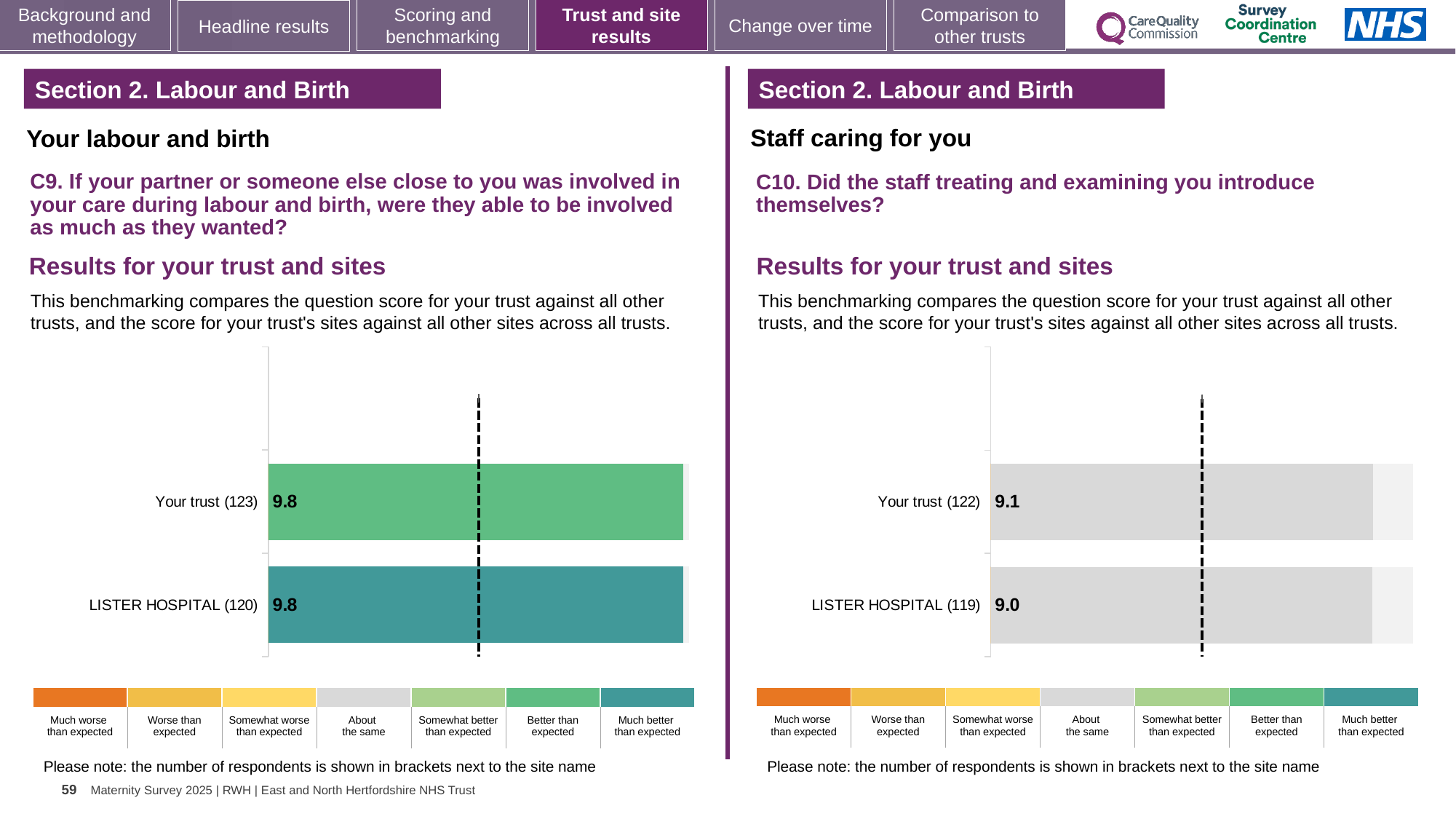
In the C9 chart on the left, which benchmark category does the colour of the LISTER HOSPITAL (120) bar correspond to in the legend? Much better than expected In the C9 chart on the left, what is the difference between the Your trust score and the LISTER HOSPITAL score? 0.0 In the C10 chart on the right, what is the difference between the Your trust score and the LISTER HOSPITAL score? 0.1 How many bars are plotted in the C10 chart on the right? 2 In the C10 chart on the right, which has the higher score, Your trust or LISTER HOSPITAL? Your trust In the C10 chart on the right, what is the score for LISTER HOSPITAL (119)? 9.0 In the C10 chart on the right, what is the score for Your trust (122)? 9.1 How many bars are plotted in the C9 chart on the left? 2 In the C10 chart on the right, which benchmark category does the grey colour of the bars correspond to in the legend? About the same What type of chart is used for the C9 results on the left? Bar chart In the C9 chart on the left, what is the score for Your trust (123)? 9.8 In the C9 chart on the left, what is the score for LISTER HOSPITAL (120)? 9.8